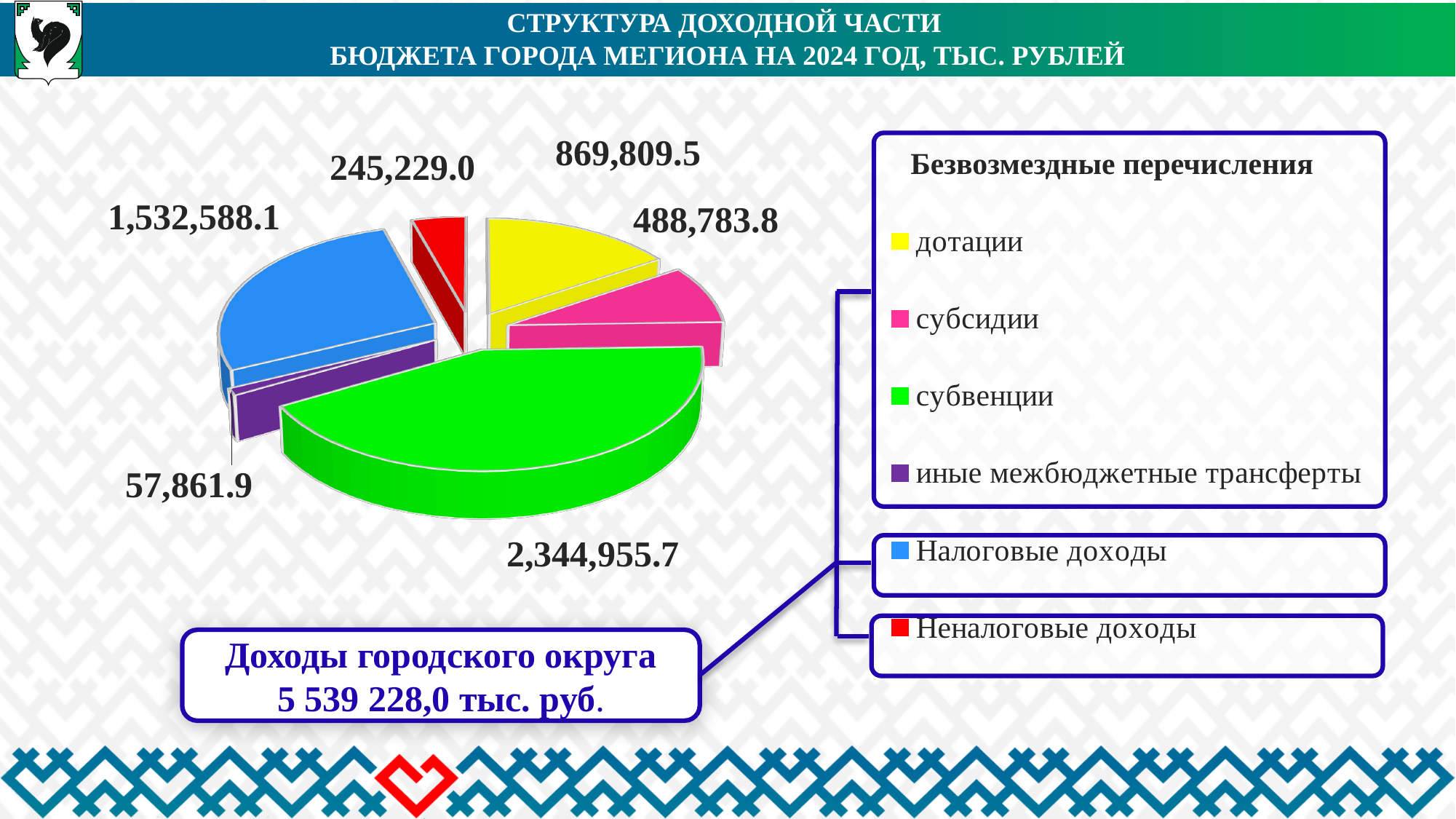
What colour is the slice for субсидии? pink What is the value for субвенции on the pie chart? 2,344,955.7 Which category has the largest slice of the pie chart? субвенции What is the value for дотации on the pie chart? 869,809.5 How many slices does the pie chart have? 6 What type of chart is shown on the slide? pie chart Which is larger, the value for дотации or the value for субсидии? дотации What is the difference between the values for Налоговые доходы and Неналоговые доходы? 1,287,359.1 What is the value for Налоговые доходы on the pie chart? 1,532,588.1 Which category has the smallest slice of the pie chart? иные межбюджетные трансферты What is the value for Неналоговые доходы on the pie chart? 245,229.0 What is the value for иные межбюджетные трансферты on the pie chart? 57,861.9